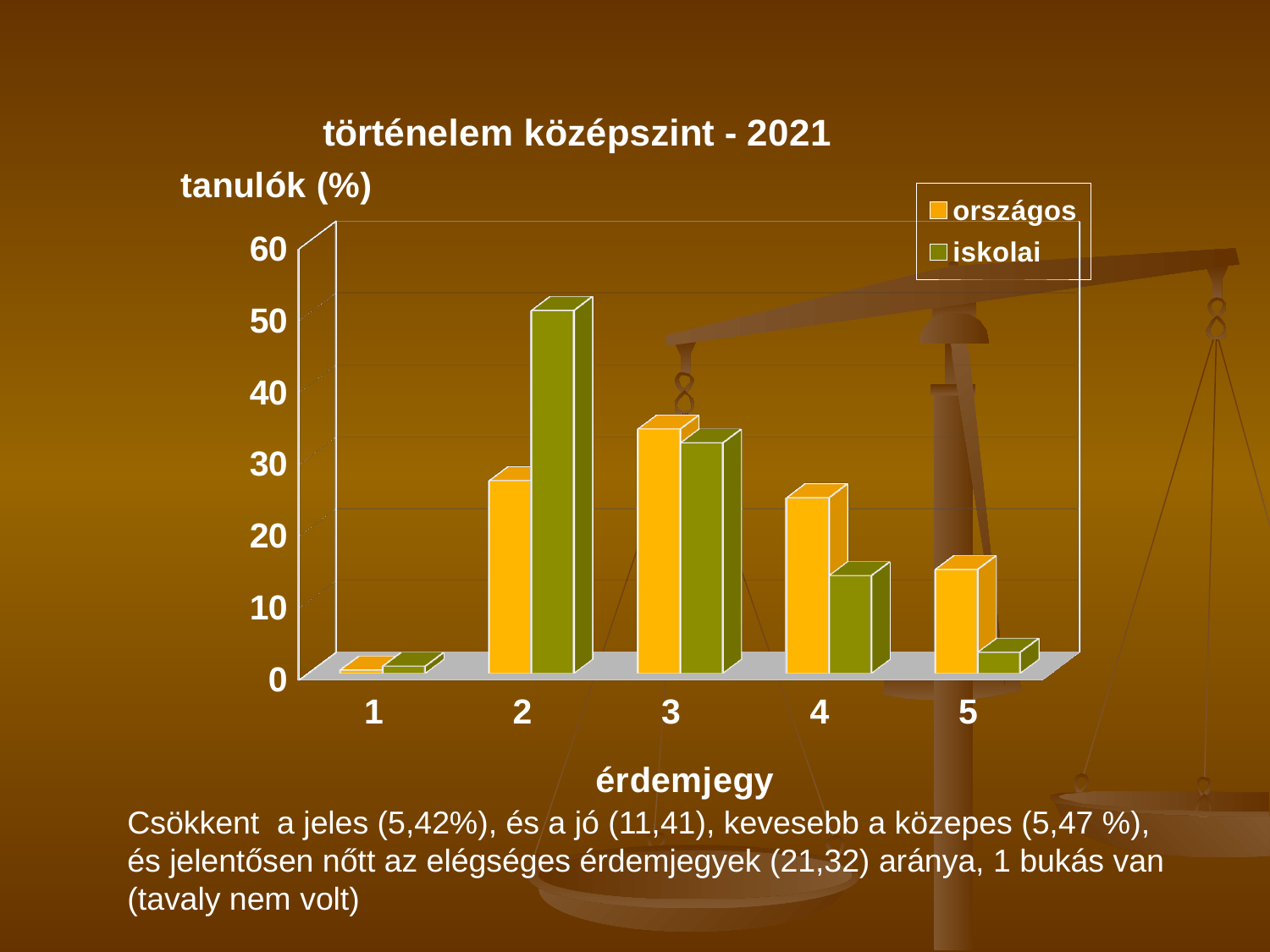
How many series does the legend list? 2 For érdemjegy 4, which series has the larger value, országos or iskolai? országos Is the országos value for érdemjegy 3 greater or less than 30? greater How many categories (érdemjegy values) are shown on the x axis? 5 Which érdemjegy has the highest value for the országos series? 3 What kind of chart is shown on the slide? bar chart Is the iskolai value for érdemjegy 5 greater or less than 10? less What is the title of the chart? történelem középszint - 2021 What is the label of the vertical axis? tanulók (%) Which érdemjegy has the highest value for the iskolai series? 2 Is the iskolai value for érdemjegy 2 greater or less than 40? greater For érdemjegy 2, which series has the larger value, országos or iskolai? iskolai